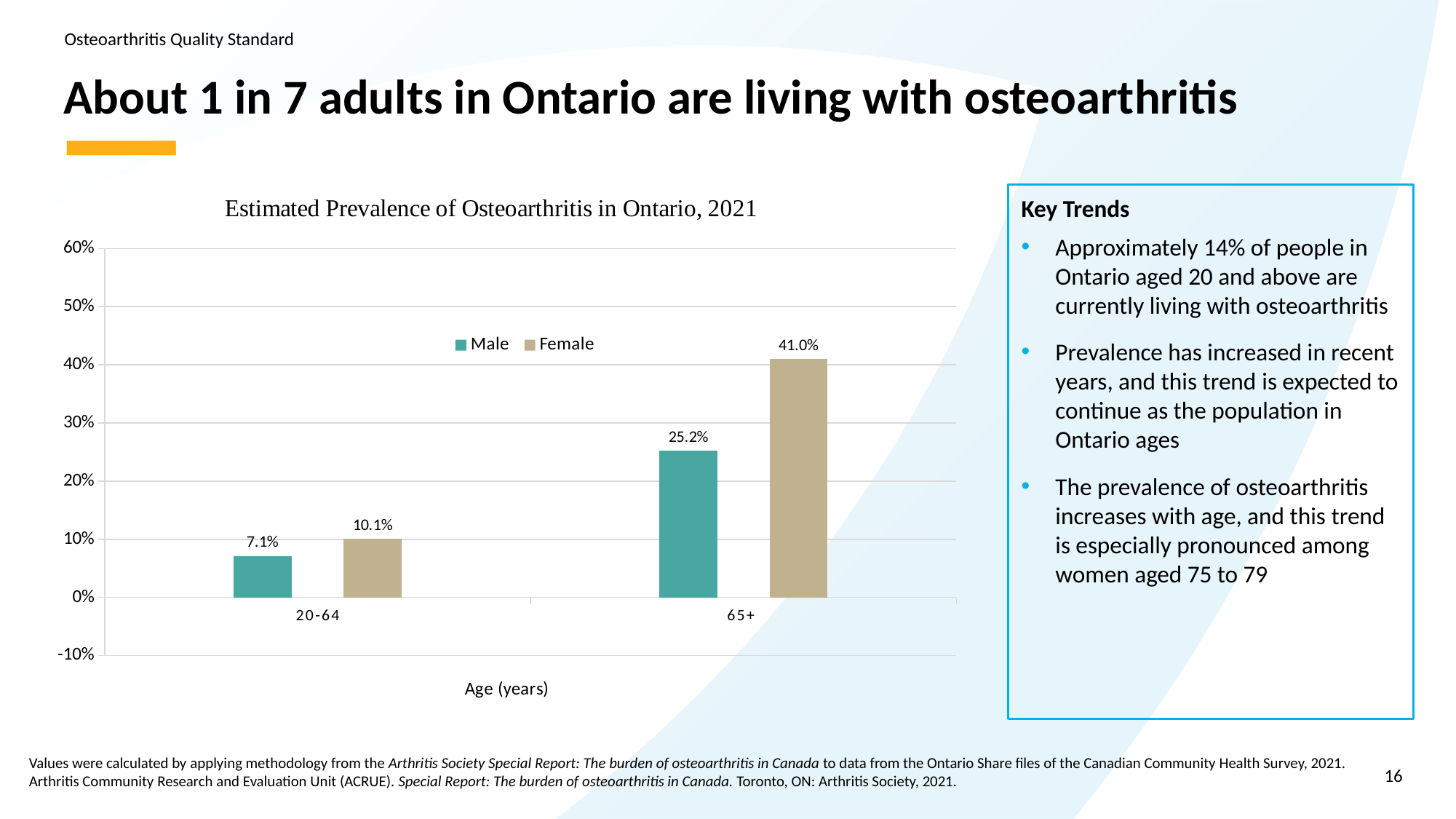
What is the estimated prevalence of osteoarthritis for males aged 65+? 25.2% What is the difference between the female and male prevalence in the 65+ age group? 15.8% What is the estimated prevalence of osteoarthritis for males aged 20-64? 7.1% How many series does the legend list? 2 What is the title of the chart? Estimated Prevalence of Osteoarthritis in Ontario, 2021 Which is larger: the prevalence for females aged 20-64 or males aged 65+? Males aged 65+ Which group has the lowest estimated prevalence of osteoarthritis? Male, 20-64 What is the difference between the female and male prevalence in the 20-64 age group? 3.0% Which group has the highest estimated prevalence of osteoarthritis? Female, 65+ How many age categories are shown on the x axis? 2 What is the estimated prevalence of osteoarthritis for females aged 65+? 41.0% What kind of chart is shown on the slide? Bar chart